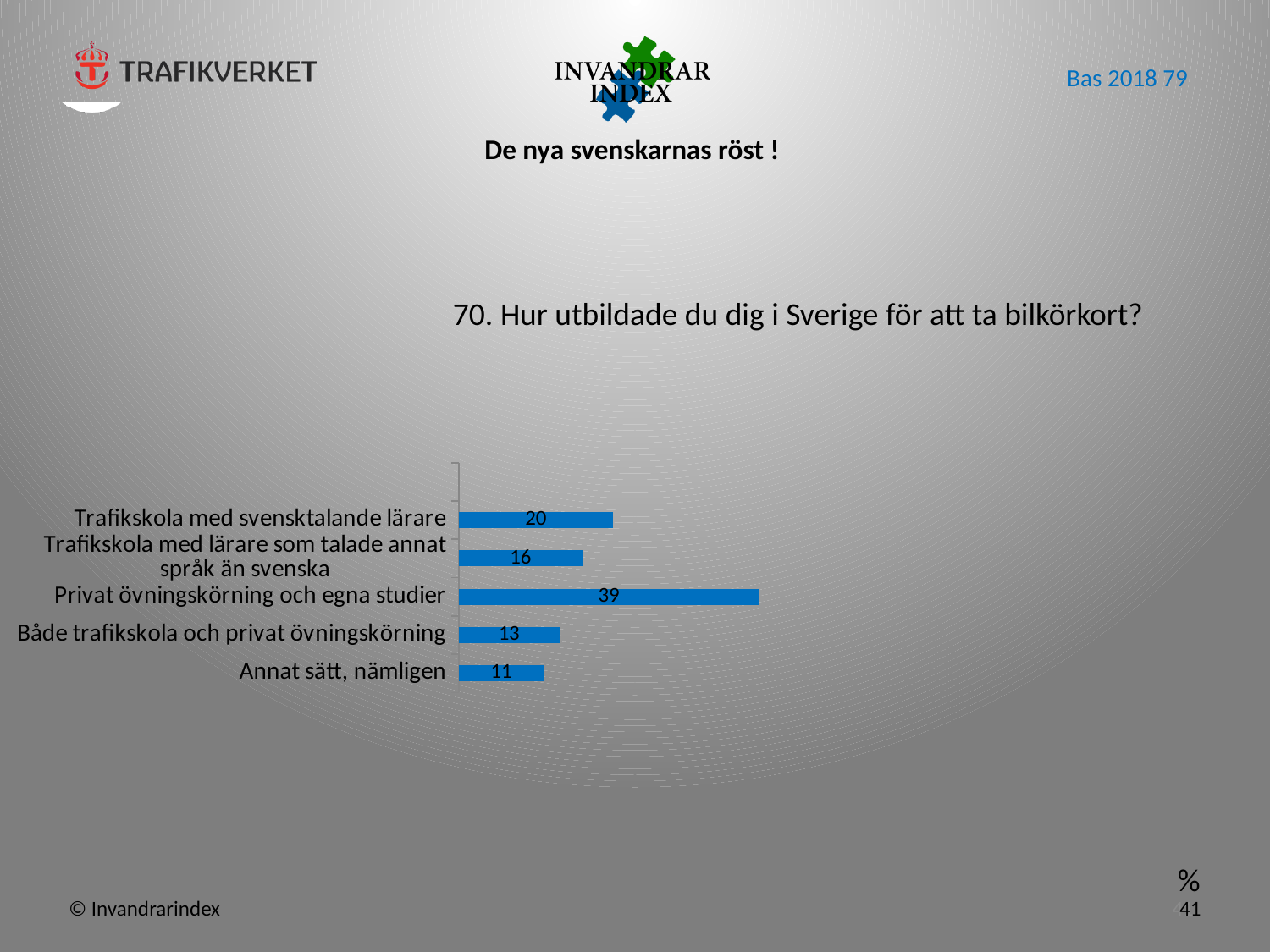
What kind of chart is shown on the slide? Bar chart What is the value for "Privat övningskörning och egna studier"? 39 How many categories are shown in the chart? 5 Which is larger: the value for "Trafikskola med svensktalande lärare" or "Trafikskola med lärare som talade annat språk än svenska"? Trafikskola med svensktalande lärare What is the value for "Både trafikskola och privat övningskörning"? 13 What is the difference between the values for "Privat övningskörning och egna studier" and "Trafikskola med svensktalande lärare"? 19 What is the difference between the values for "Trafikskola med lärare som talade annat språk än svenska" and "Både trafikskola och privat övningskörning"? 3 Which category has the highest value? Privat övningskörning och egna studier What is the value for "Trafikskola med svensktalande lärare"? 20 What question number and text is the chart about? 70. Hur utbildade du dig i Sverige för att ta bilkörkort? What is the value for "Annat sätt, nämligen"? 11 Which category has the lowest value? Annat sätt, nämligen